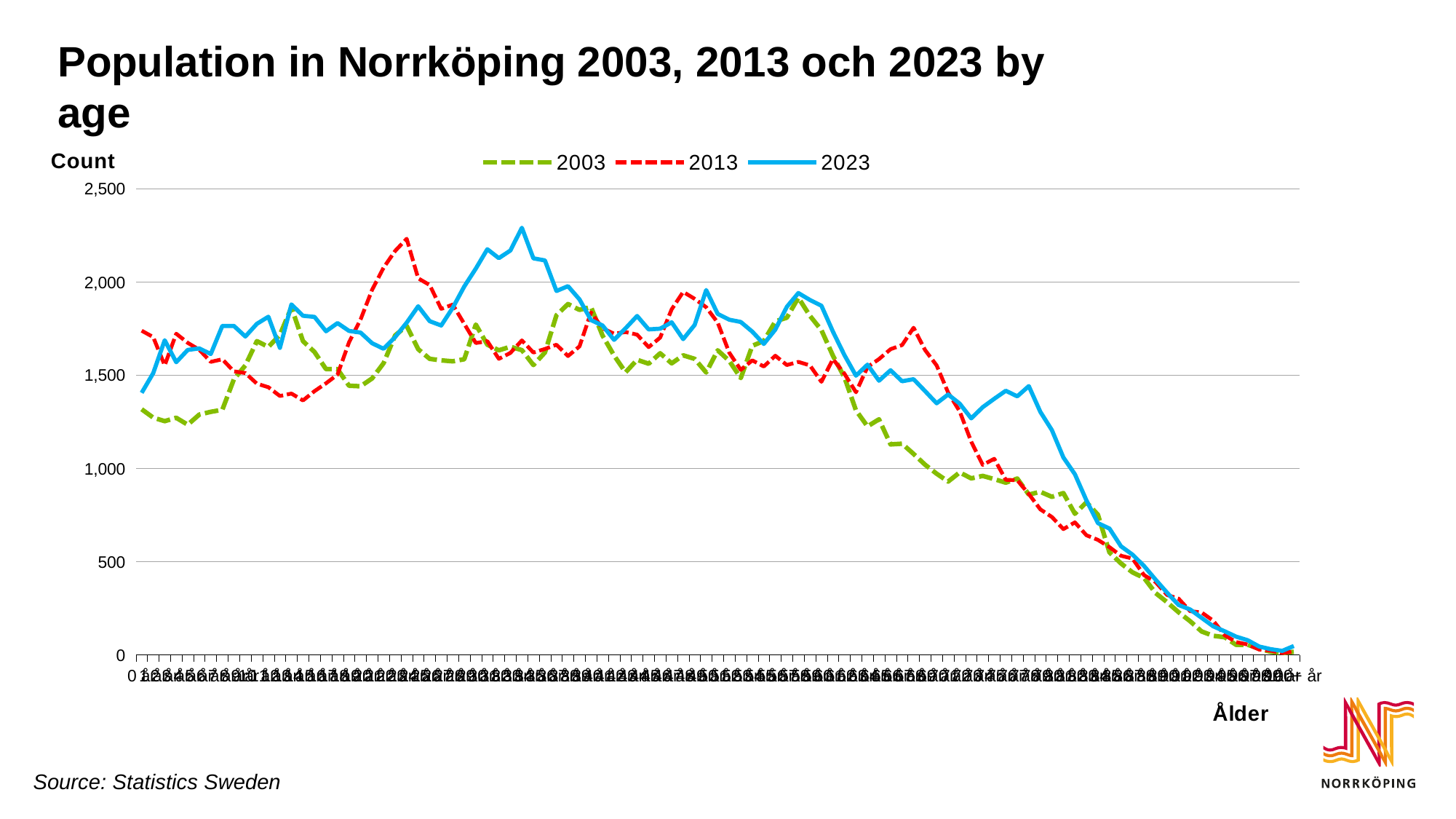
Is the value of the 2013 series at the leftmost point (age 0) greater or less than 1,500? greater What kind of chart is shown on the slide? line chart What is the label of the vertical axis? Count Is the value of the 2003 series at the leftmost point (age 0) greater or less than 1,500? less Which series has the lowest value at the leftmost point (age 0)? 2003 Which years are listed in the chart legend? 2003, 2013, 2023 Which series has the highest value at the leftmost point (age 0)? 2013 Does any series reach the 2,500 gridline? No Do the values of all three series rise or fall toward the right end of the x axis? fall How many series does the legend list? 3